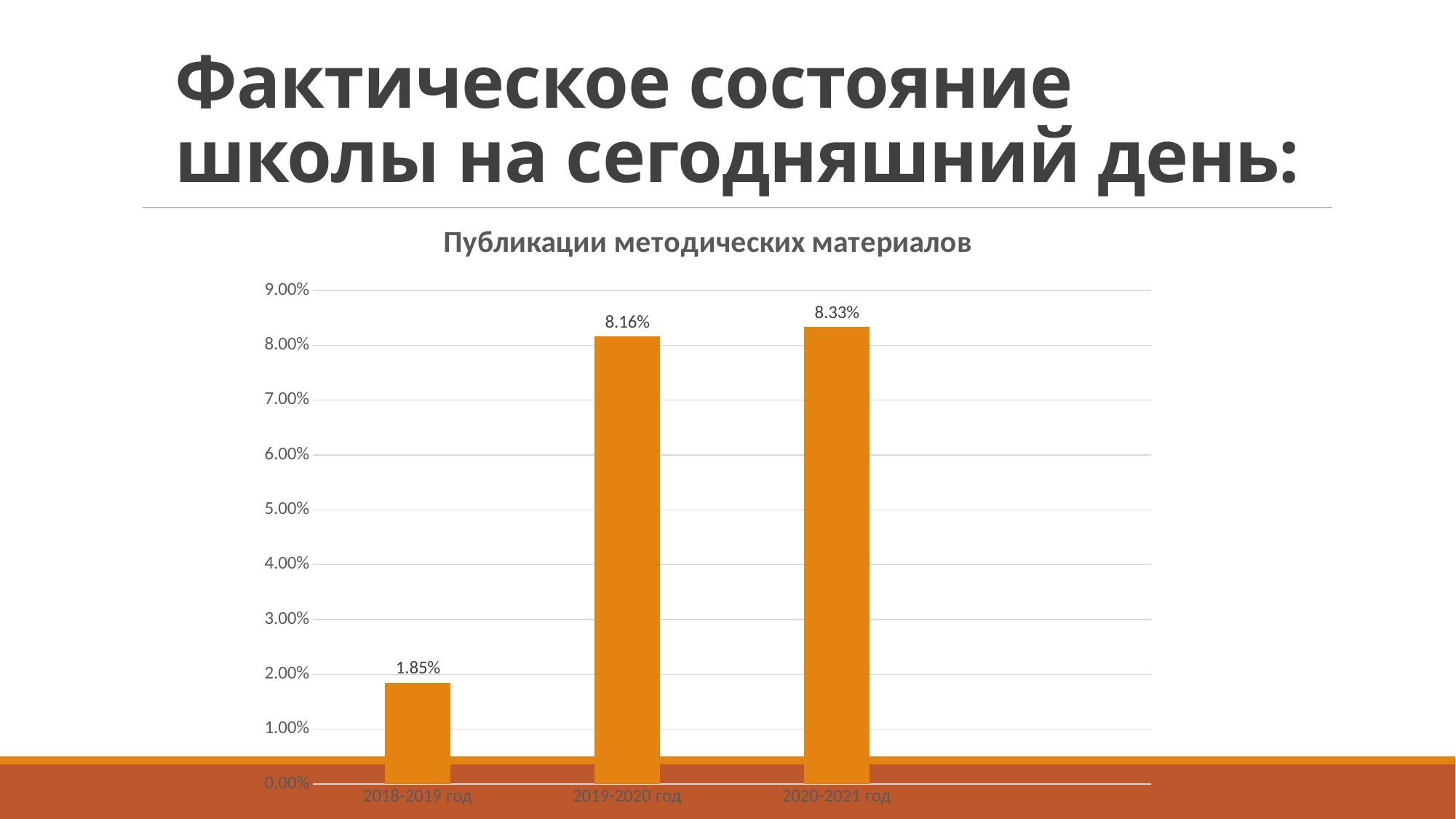
What is the difference between the values for 2019-2020 год and 2018-2019 год? 6.31% Which is larger, the value for 2018-2019 год or the value for 2019-2020 год? 2019-2020 год Which category has the lowest value? 2018-2019 год What is the value for 2019-2020 год? 8.16% What is the title of the chart? Публикации методических материалов How many categories are shown on the x axis? 3 What is the value for 2018-2019 год? 1.85% What is the difference between the values for 2020-2021 год and 2019-2020 год? 0.17% What is the value for 2020-2021 год? 8.33% Is the value for 2018-2019 год greater or less than 2.00%? less Which category has the highest value? 2020-2021 год What kind of chart is shown on the slide? bar chart